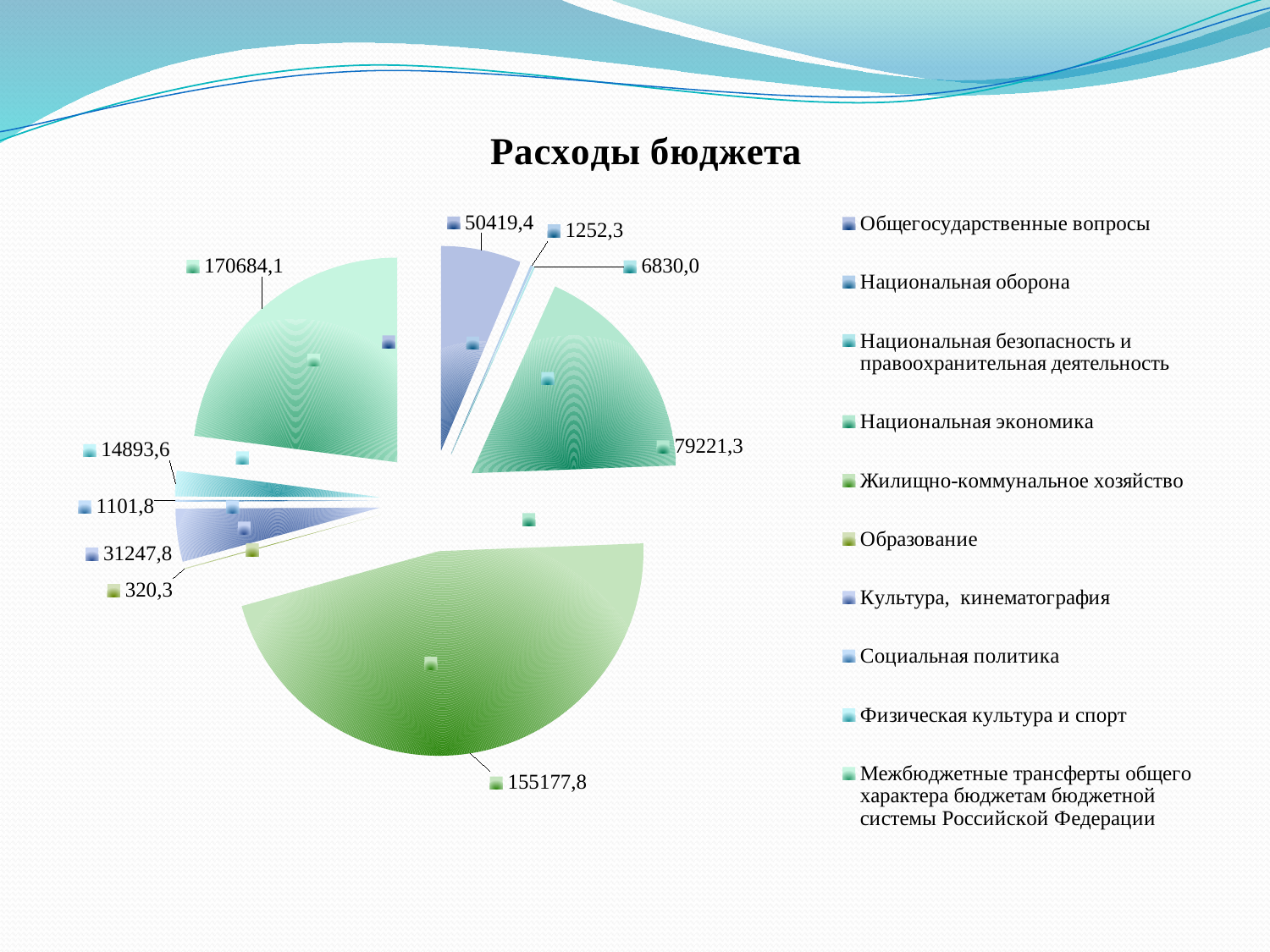
How many entries does the legend list? 10 What is the value for Жилищно-коммунальное хозяйство? 155177,8 Which category has the smallest value? Образование How many categories (slices) does the pie chart have? 10 Which is larger: the value for Культура, кинематография or the value for Физическая культура и спорт? Культура, кинематография What is the value for Национальная экономика? 79221,3 What is the difference between the values for Национальная экономика and Общегосударственные вопросы? 28801,9 What is the largest value labelled on the pie chart? 170684,1 What is the title of the chart? Расходы бюджета What is the value for Общегосударственные вопросы? 50419,4 What kind of chart is shown on the slide? Pie chart What is the smallest value labelled on the pie chart? 320,3